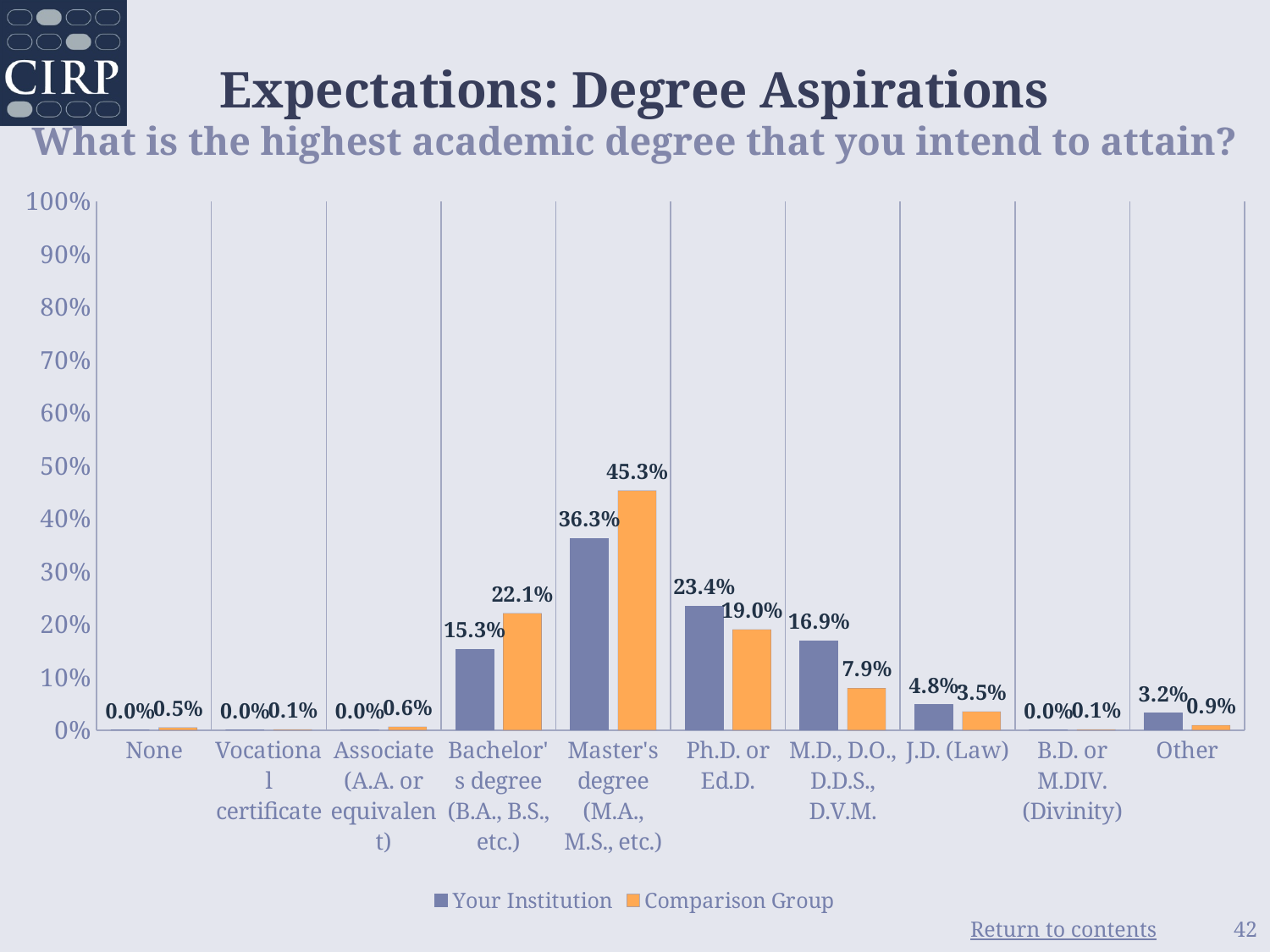
What is the difference between the Your Institution and Comparison Group values for M.D., D.O., D.D.S., D.V.M.? 9.0% What is the Comparison Group value for J.D. (Law)? 3.5% What is the difference between the Comparison Group and Your Institution values for Master's degree (M.A., M.S., etc.)? 9.0% What is the Your Institution value for Master's degree (M.A., M.S., etc.)? 36.3% What is the Comparison Group value for Bachelor's degree (B.A., B.S., etc.)? 22.1% How many degree categories are shown on the x axis? 10 What is the Your Institution value for M.D., D.O., D.D.S., D.V.M.? 16.9% What question does the chart's subtitle ask? What is the highest academic degree that you intend to attain? For Ph.D. or Ed.D., which series has the larger value, Your Institution or Comparison Group? Your Institution How many series does the legend list? 2 Which degree category has the highest Comparison Group value? Master's degree (M.A., M.S., etc.) What kind of chart is shown on the slide? Bar chart